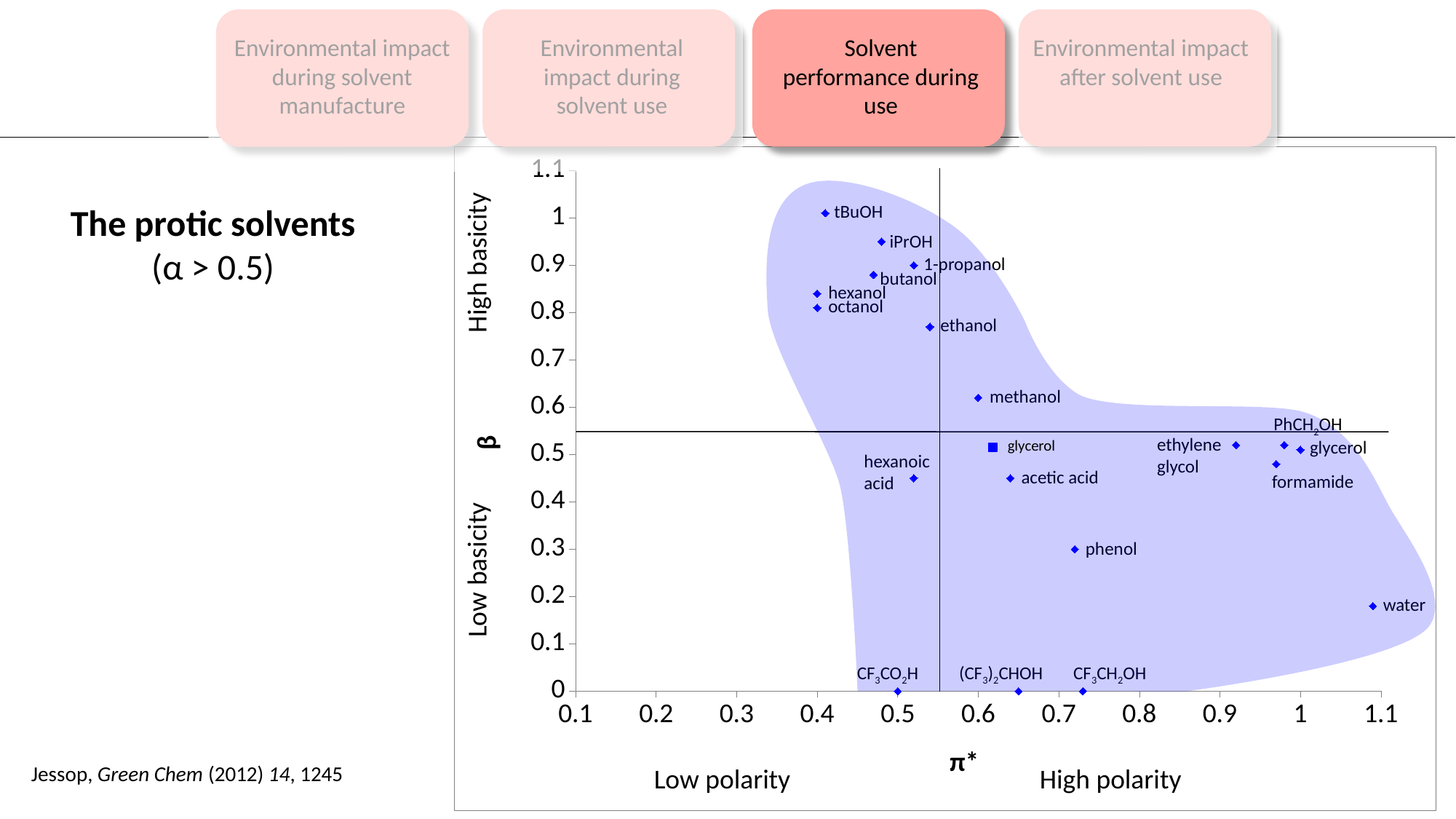
Is the π* value for water greater or less than 1? greater Which solvent has the highest π* value on the chart? water What is the β value plotted for CF3CO2H? 0 What is the label on the x axis of the chart? π* What is the β value plotted for CF3CH2OH? 0 Which solvent has the highest β value on the chart? tBuOH Is the β value for tBuOH greater or less than 0.9? greater Is the β value for phenol greater or less than 0.4? less Which has the higher β value, methanol or phenol? methanol What kind of chart is shown on the slide? scatter chart Which has the higher π* value, water or tBuOH? water